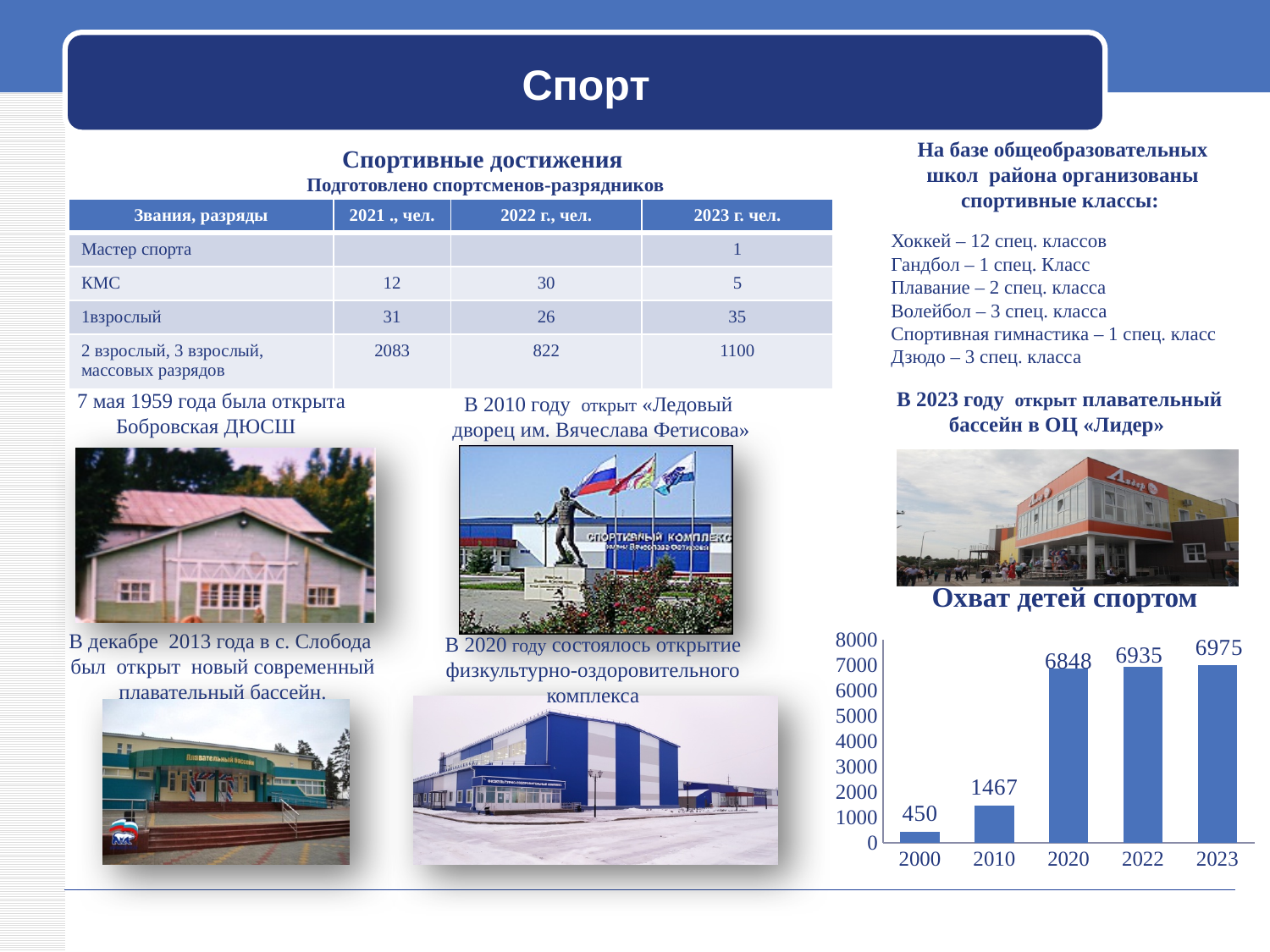
Which year has the lowest value in the 'Охват детей спортом' chart? 2000 What kind of chart is 'Охват детей спортом'? bar chart How many years are shown in the 'Охват детей спортом' chart? 5 What is the value for 2023 in the 'Охват детей спортом' chart? 6975 In the 'Охват детей спортом' chart, which is larger: the value for 2020 or the value for 2010? 2020 Which year has the highest value in the 'Охват детей спортом' chart? 2023 In the 'Охват детей спортом' chart, what is the difference between the values for 2010 and 2000? 1017 Do the values in the 'Охват детей спортом' chart rise or fall from 2000 to 2023? rise In the 'Охват детей спортом' chart, what is the difference between the values for 2023 and 2022? 40 What is the value for 2010 in the 'Охват детей спортом' chart? 1467 What is the value for 2020 in the 'Охват детей спортом' chart? 6848 What is the value for 2000 in the 'Охват детей спортом' chart? 450